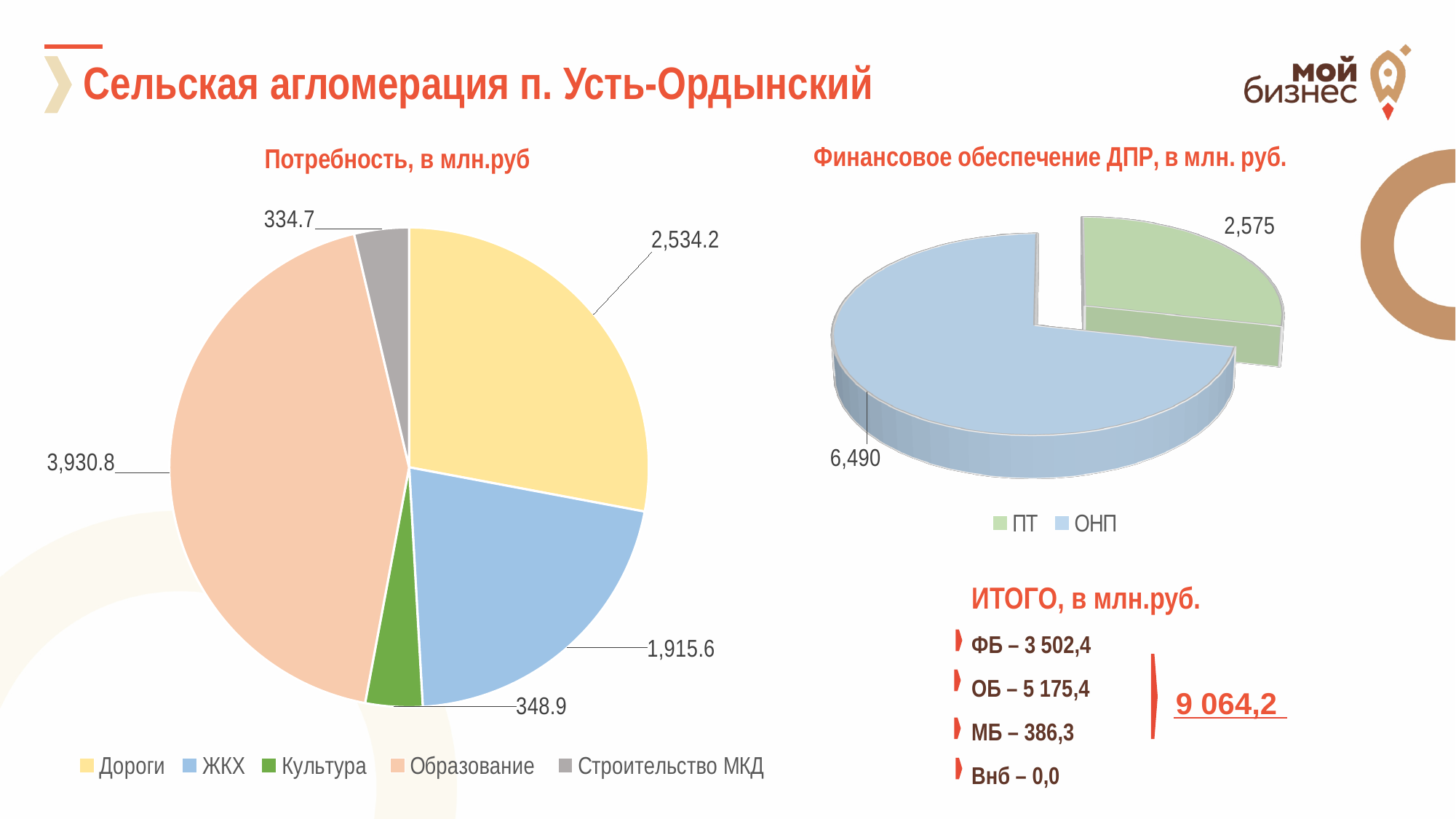
How many entries does the legend of the 'Финансовое обеспечение ДПР, в млн. руб.' chart list? 2 What type of chart is the 'Финансовое обеспечение ДПР, в млн. руб.' chart? Pie chart In the 'Потребность, в млн.руб' chart, which is larger: Дороги or ЖКХ? Дороги In the 'Потребность, в млн.руб' chart, which category has the lowest value? Строительство МКД In the 'Потребность, в млн.руб' chart, which category has the highest value? Образование In the 'Потребность, в млн.руб' chart, what is the value for ЖКХ? 1,915.6 How many categories does the 'Потребность, в млн.руб' chart show? 5 In the 'Потребность, в млн.руб' chart, which colour represents Культура? Green In the 'Финансовое обеспечение ДПР, в млн. руб.' chart, what is the value for ОНП? 6,490 In the 'Финансовое обеспечение ДПР, в млн. руб.' chart, what is the difference between ОНП and ПТ? 3,915 In the 'Потребность, в млн.руб' chart, what is the difference between Образование and Дороги? 1,396.6 In the 'Потребность, в млн.руб' chart, what is the value for Образование? 3,930.8